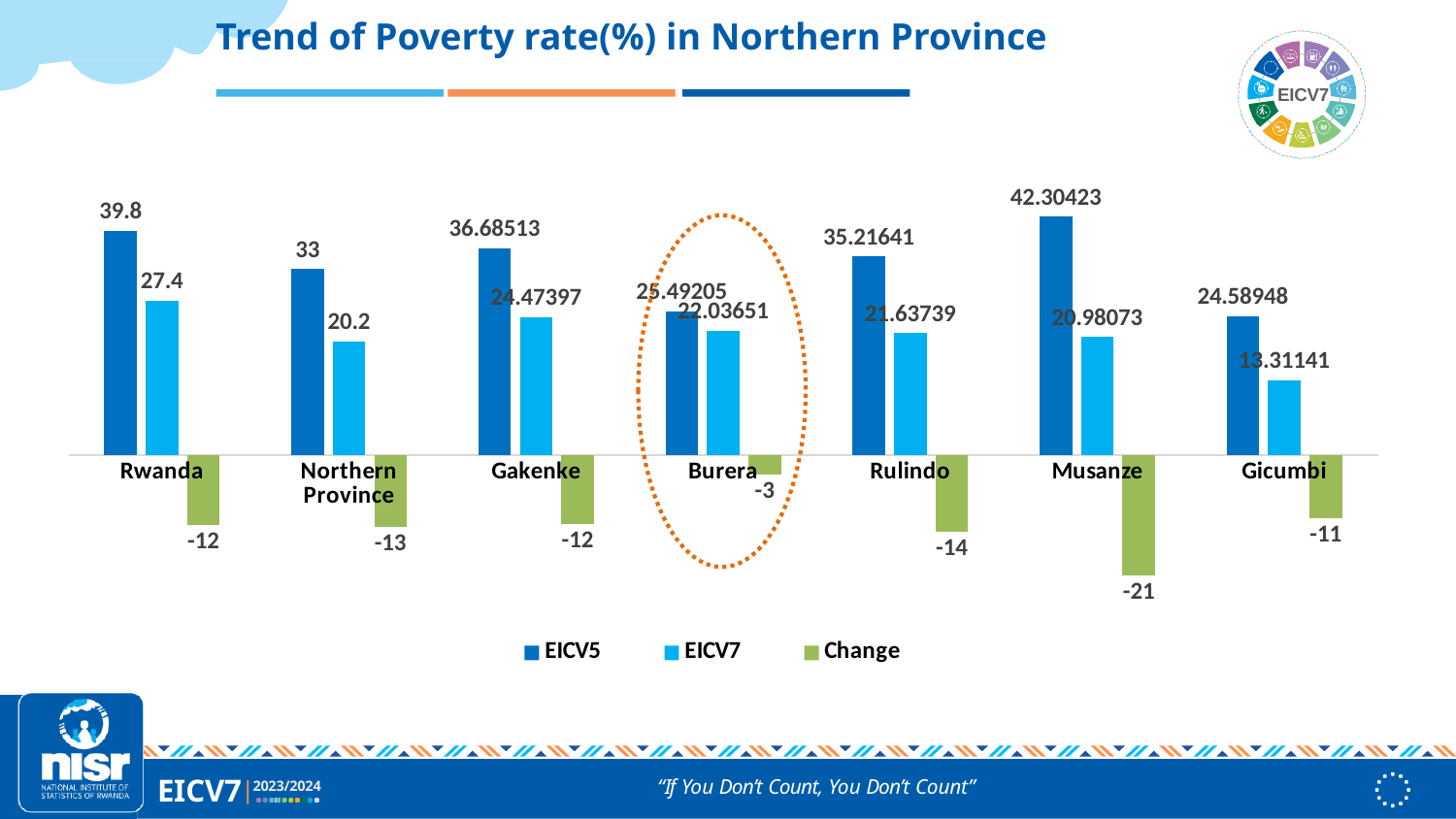
Which category has the lowest EICV7 poverty rate? Gicumbi What is the EICV5 poverty rate for Musanze? 42.30423 How many categories are shown on the x axis of the chart? 7 What is the EICV7 poverty rate for Gicumbi? 13.31141 Which category has the highest EICV5 poverty rate? Musanze Which category is highlighted with a dotted orange circle? Burera What is the difference between the EICV5 and EICV7 poverty rates for Rwanda? 12.4 What is the EICV7 poverty rate for Northern Province? 20.2 Is the EICV5 poverty rate higher for Gakenke or for Rulindo? Gakenke How many series does the legend list? 3 What kind of chart is shown on the slide? Bar chart What is the Change value shown for Burera? -3